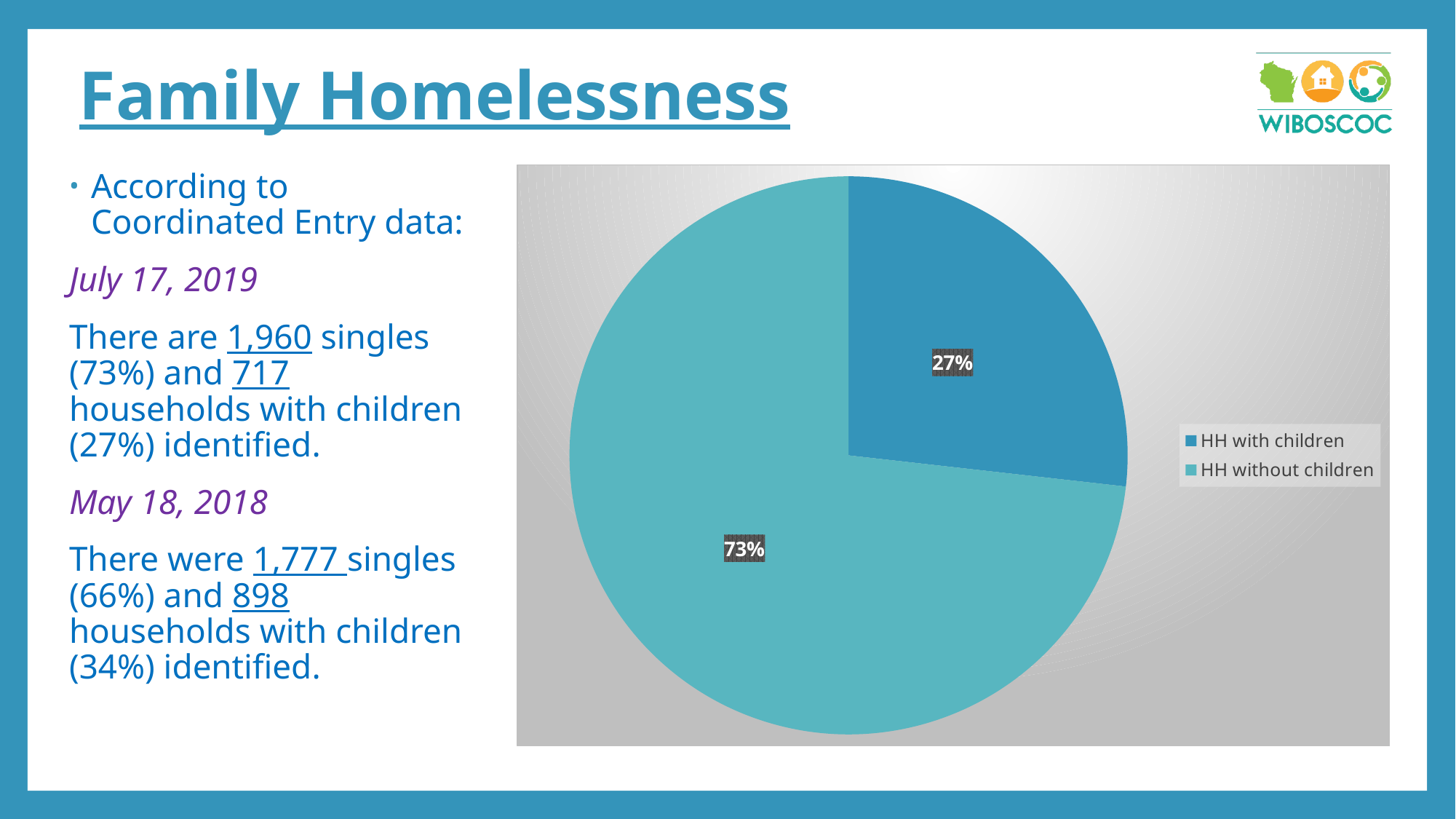
Which slice of the pie is the largest? HH without children How many entries does the legend list? 2 What is the difference in percentage points between the "HH without children" slice and the "HH with children" slice? 46 How many slices does the pie chart have? 2 Which slice of the pie is the smallest? HH with children Which is larger, the "HH with children" slice or the "HH without children" slice? HH without children Where is the legend positioned relative to the pie? to the right Is the share for "HH with children" greater or less than 50%? less What share of the pie is labelled "HH with children"? 27% What share of the pie is labelled "HH without children"? 73% What kind of chart is shown on the slide? pie chart What colour is the "HH with children" slice in the pie chart? dark blue